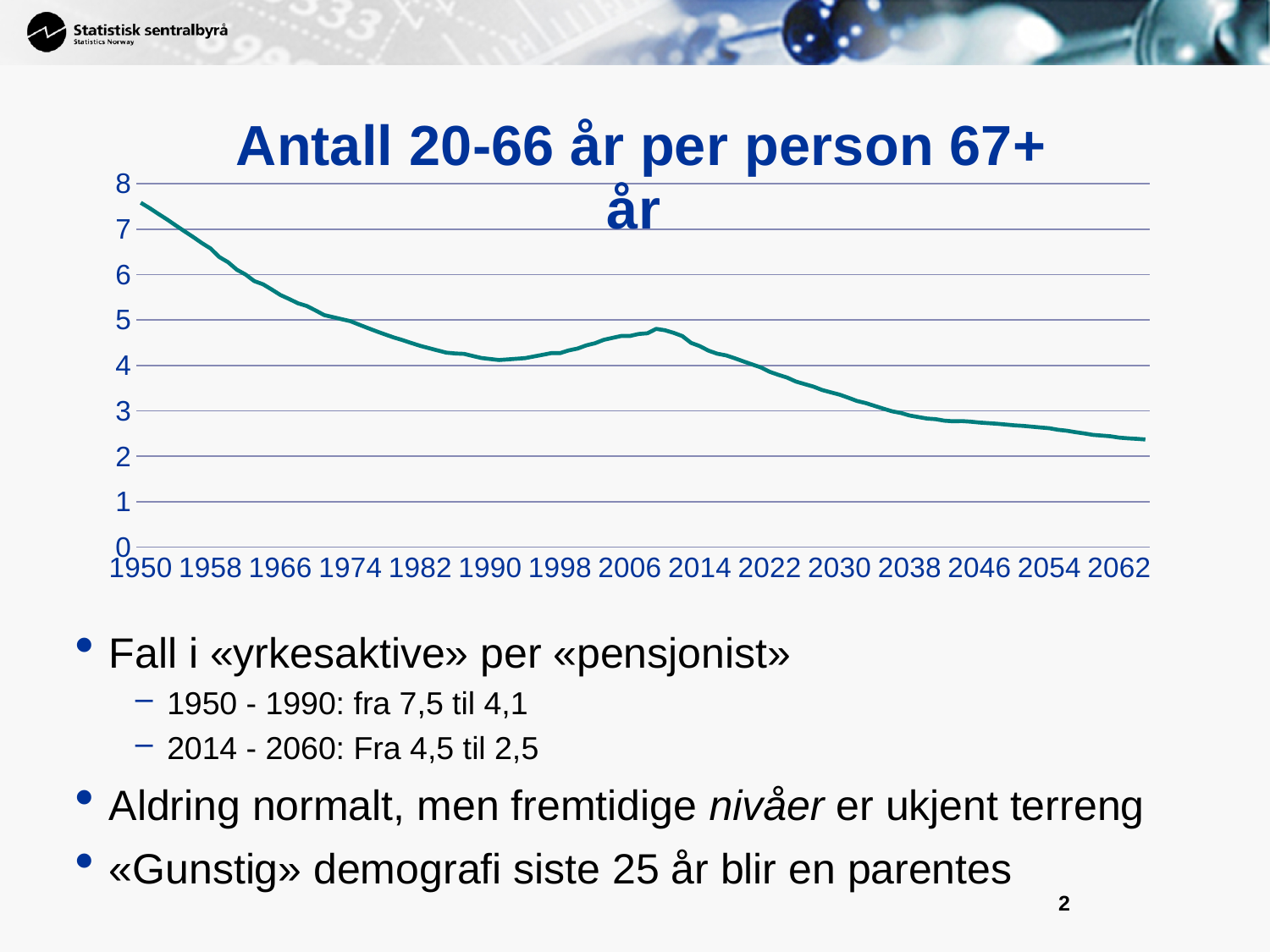
What is the title of the chart? Antall 20-66 år per person 67+ år Is the value for 1990 greater or less than 5? less Which year has the larger value, 1958 or 2022? 1958 Is the value for 1950 greater or less than 7? greater What kind of chart is shown on the slide? line chart In which year shown on the x axis is the value lowest? 2062 Is the value for 1966 greater or less than 5? greater Does the line generally rise or fall from 1950 to 2062? fall In which year shown on the x axis is the value highest? 1950 How many year labels are shown on the x axis? 15